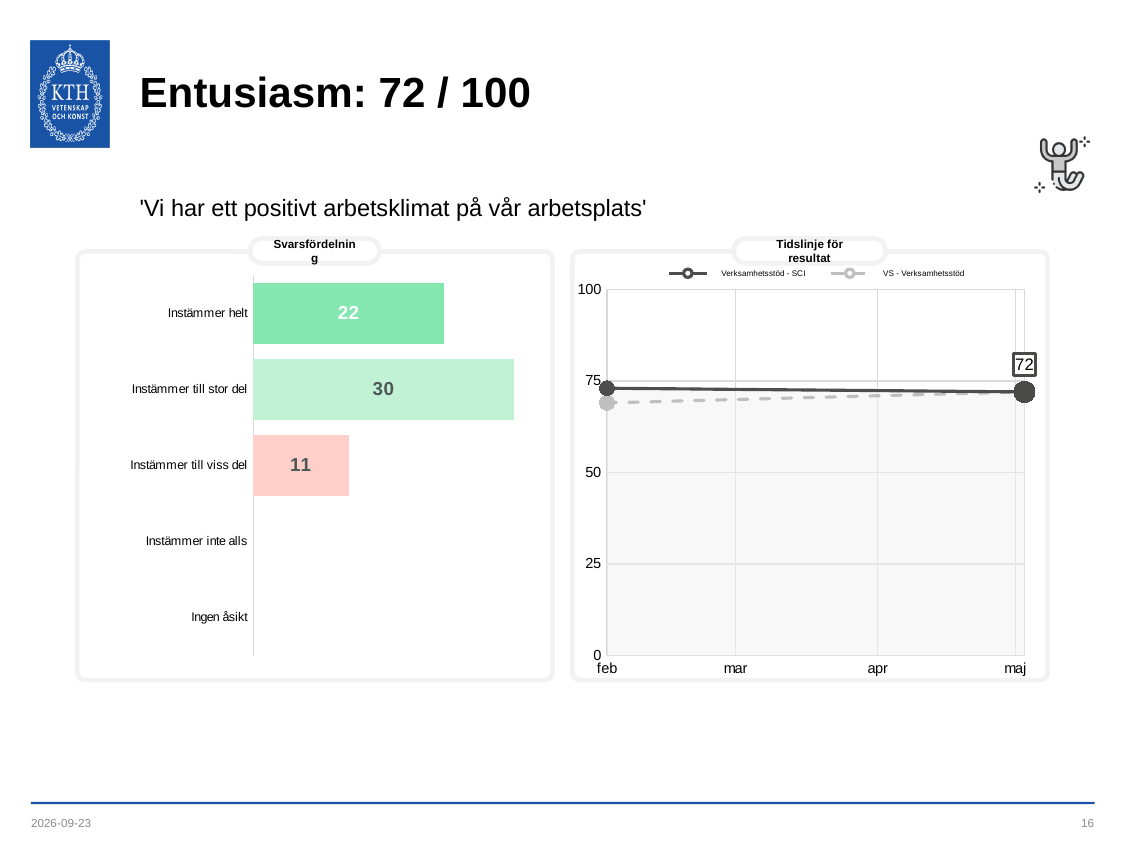
In the 'Svarsfördelning' chart, what is the value for 'Instämmer helt'? 22 In the 'Svarsfördelning' chart, which category has the highest value? Instämmer till stor del In the 'Svarsfördelning' chart, what is the value for 'Instämmer till stor del'? 30 What kind of chart is the 'Tidslinje för resultat' chart? Line chart In the 'Tidslinje för resultat' chart, is the value for 'VS - Verksamhetsstöd' in feb greater or less than 50? greater In the 'Svarsfördelning' chart, which is larger: 'Instämmer helt' or 'Instämmer till viss del'? Instämmer helt In the 'Tidslinje för resultat' chart, what is the value labelled for 'Verksamhetsstöd - SCI' in maj? 72 How many series does the legend of the 'Tidslinje för resultat' chart list? 2 What kind of chart is the 'Svarsfördelning' chart? Bar chart How many categories are listed on the 'Svarsfördelning' chart? 5 In the 'Svarsfördelning' chart, what is the value for 'Instämmer till viss del'? 11 In the 'Svarsfördelning' chart, what is the difference between 'Instämmer till stor del' and 'Instämmer till viss del'? 19